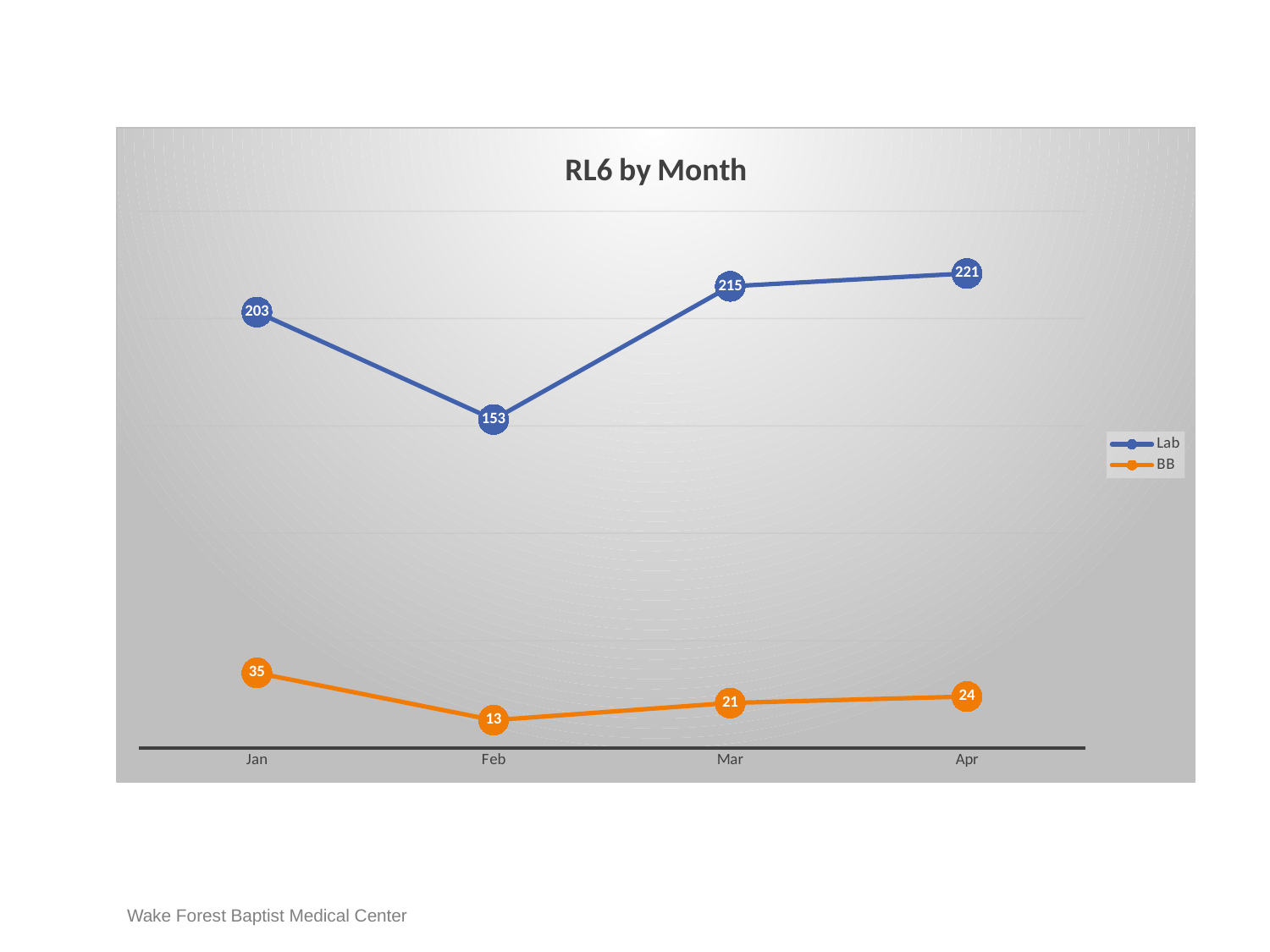
What is the Lab value for Feb? 153 What is the difference between the BB values for Jan and Feb? 22 What kind of chart is this? Line chart In which month is the BB value lowest? Feb Which is larger, the Lab value for Jan or the Lab value for Mar? Mar What is the title of the chart? RL6 by Month In which month is the Lab value highest? Apr How many months are shown on the x axis? 4 How many series does the legend list? 2 What is the Lab value for Jan? 203 What is the difference between the Lab values for Mar and Feb? 62 What is the BB value for Apr? 24